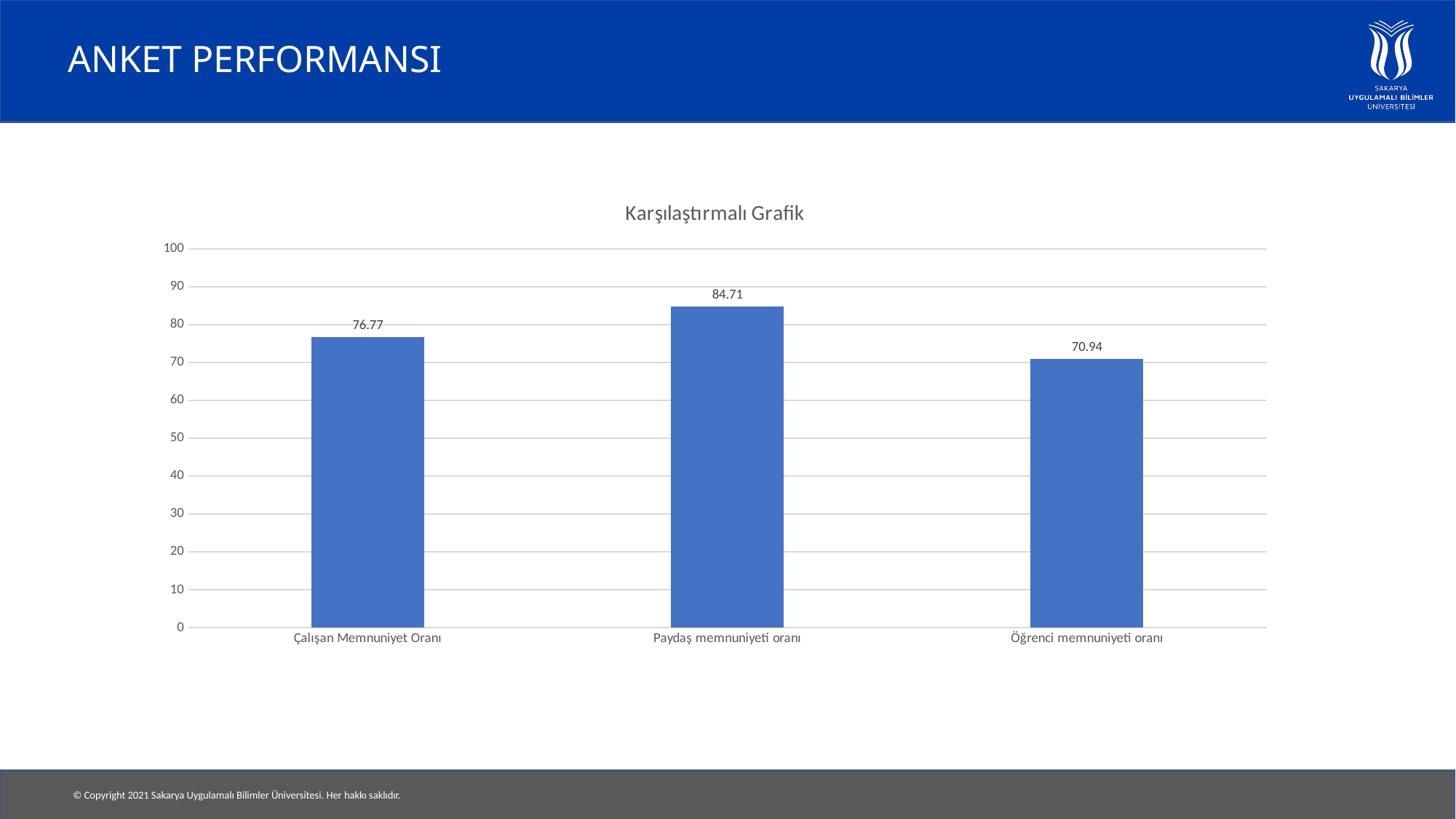
Which is larger, the value for Çalışan Memnuniyet Oranı or the value for Öğrenci memnuniyeti oranı? Çalışan Memnuniyet Oranı What is the difference between the values for Paydaş memnuniyeti oranı and Çalışan Memnuniyet Oranı? 7.94 How many categories are shown in the chart? 3 What is the title of the chart? Karşılaştırmalı Grafik What kind of chart is shown on the slide? Bar chart What is the value for Çalışan Memnuniyet Oranı? 76.77 What is the value for Paydaş memnuniyeti oranı? 84.71 What is the value for Öğrenci memnuniyeti oranı? 70.94 Which category has the lowest value? Öğrenci memnuniyeti oranı What is the difference between the values for Çalışan Memnuniyet Oranı and Öğrenci memnuniyeti oranı? 5.83 Which category has the highest value? Paydaş memnuniyeti oranı Is the value for Paydaş memnuniyeti oranı greater or less than 80? greater